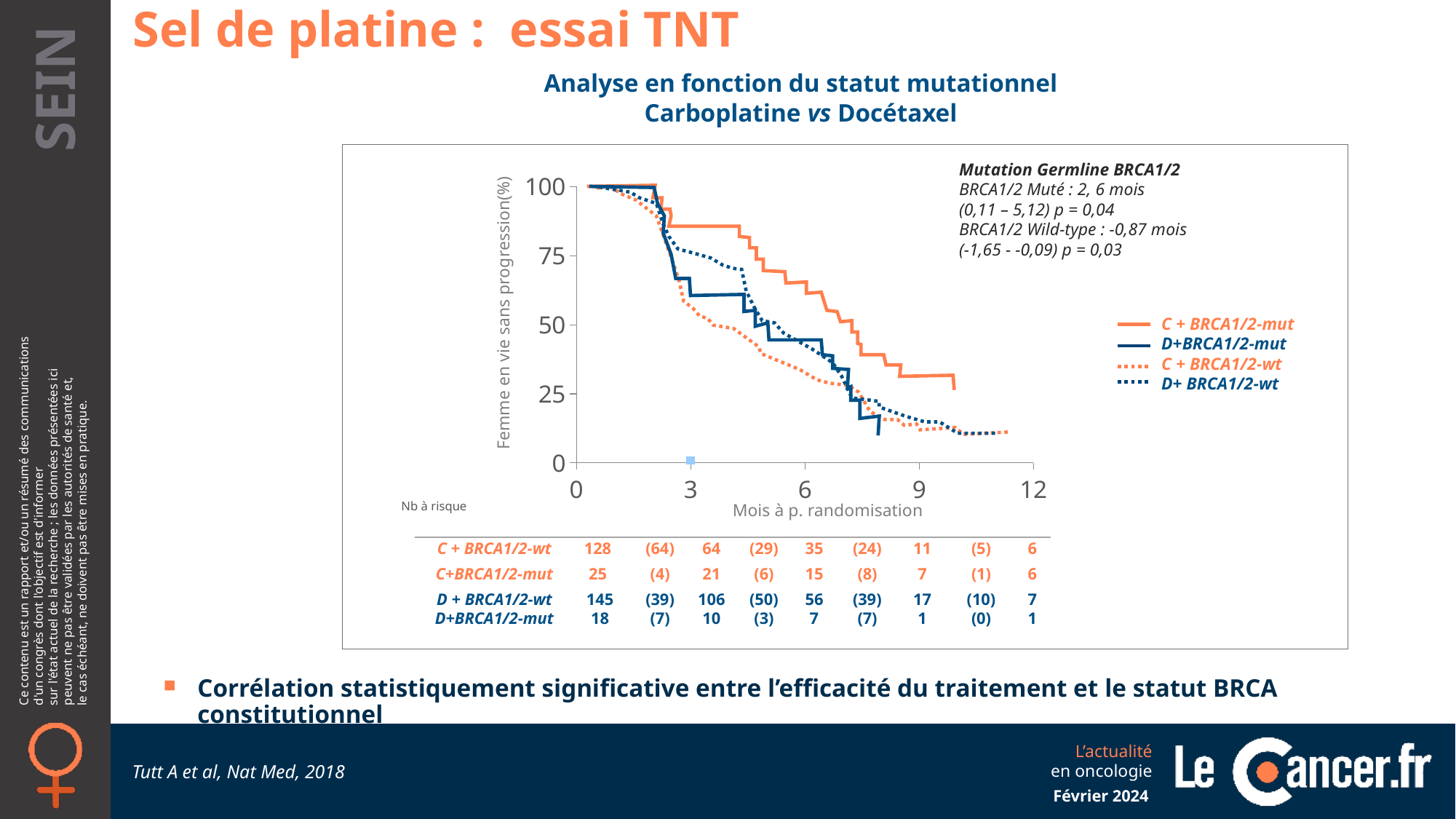
What is the label of the x axis of the chart? Mois à p. randomisation What is the label of the y axis of the chart? Femme en vie sans progression(%) How many series does the legend of the chart list? 4 Which curve is highest at 6 months? C + BRCA1/2-mut What kind of chart is shown on the slide? Line chart (Kaplan-Meier survival curve) According to the 'Nb à risque' table, how many patients were at risk in the C + BRCA1/2-wt group at 0 months? 128 According to the 'Nb à risque' table, how many patients were at risk in the D+BRCA1/2-mut group at 9 months? 1 Is the progression-free survival value for the C + BRCA1/2-mut curve at 6 months greater or less than 50? greater Which group had the smallest number at risk at 0 months in the 'Nb à risque' table? D+BRCA1/2-mut According to the 'Nb à risque' table, how many patients were at risk in the D + BRCA1/2-wt group at 6 months? 56 What is the difference between the number at risk at 0 months for D + BRCA1/2-wt and for C + BRCA1/2-wt? 17 Which group had the largest number at risk at 0 months in the 'Nb à risque' table? D + BRCA1/2-wt